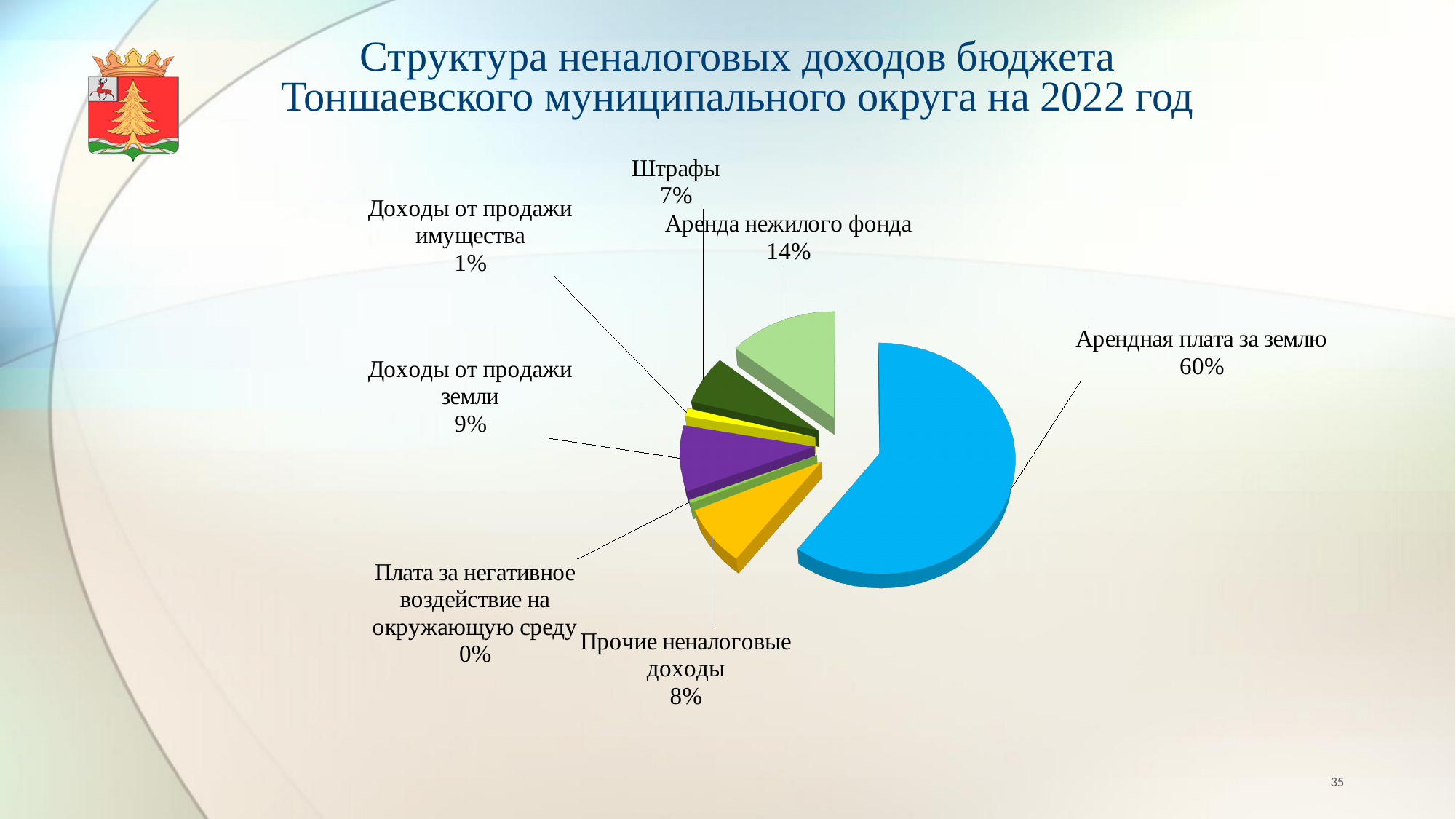
What percentage is shown for "Аренда нежилого фонда"? 14% What percentage is shown for "Штрафы"? 7% Which is larger: "Доходы от продажи земли" or "Прочие неналоговые доходы"? Доходы от продажи земли Which category has the smallest share of the pie? Плата за негативное воздействие на окружающую среду Which category has the largest share of the pie? Арендная плата за землю What percentage is shown for "Доходы от продажи земли"? 9% What percentage is shown for "Плата за негативное воздействие на окружающую среду"? 0% What is the difference in percentage points between "Аренда нежилого фонда" and "Штрафы"? 7 What share of the pie does "Арендная плата за землю" represent? 60% What type of chart is shown on the slide? Pie chart What percentage is shown for "Прочие неналоговые доходы"? 8% How many categories are shown in the pie chart? 7